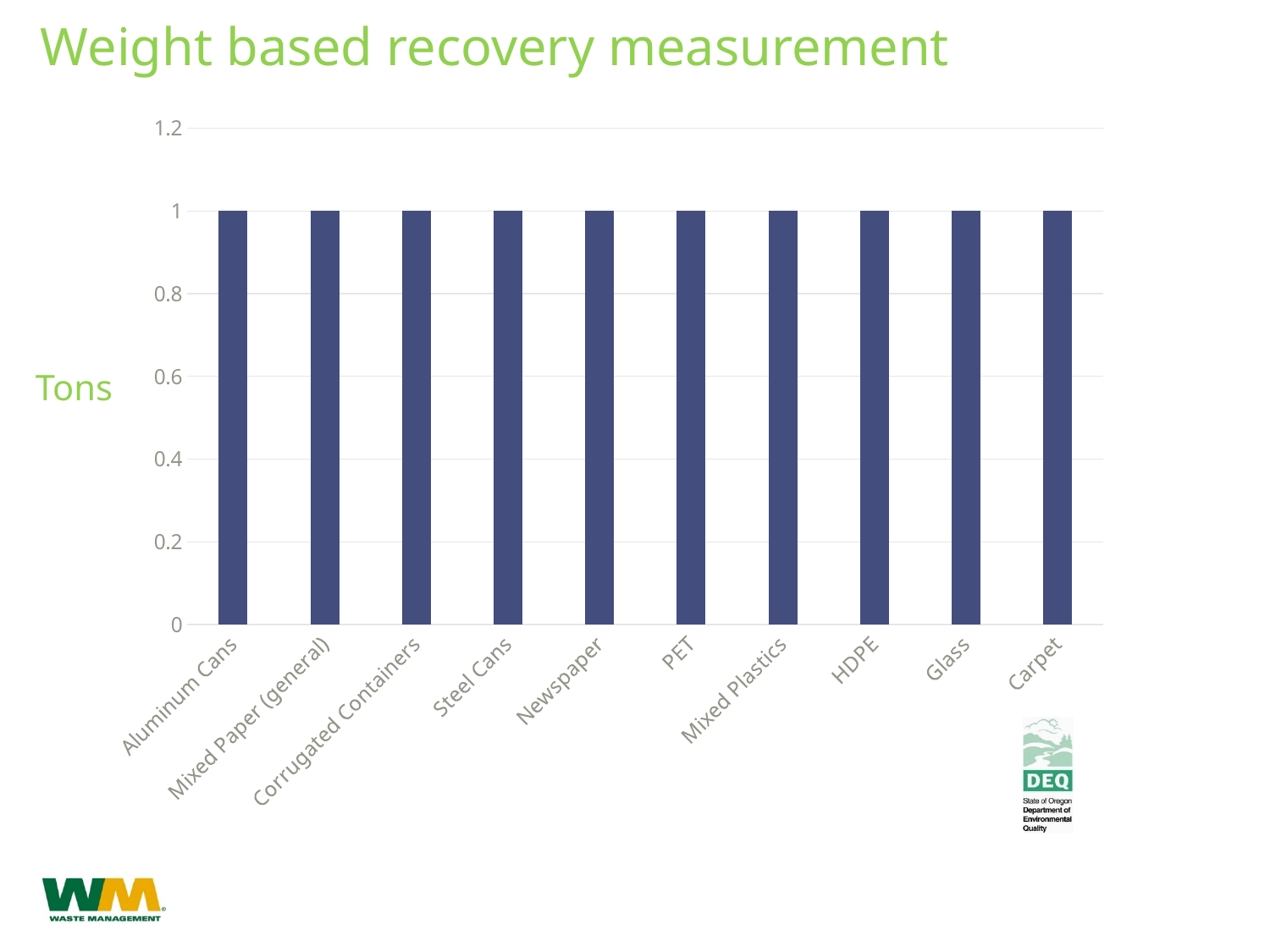
How many categories are shown on the x axis of the chart? 10 What is the value for Newspaper? 1 Is the value for HDPE greater or less than 1.2? less What is the difference between the values for Steel Cans and PET? 0 What unit is labelled on the vertical axis of the chart? Tons Do the values rise, fall, or stay the same across the categories from Aluminum Cans to Carpet? stay the same What is the value for Aluminum Cans? 1 What is the value for Mixed Plastics? 1 What is the title of the chart? Weight based recovery measurement What kind of chart is shown on the slide? bar chart What is the value for Carpet? 1 Is the value for Glass greater or less than 0.8? greater